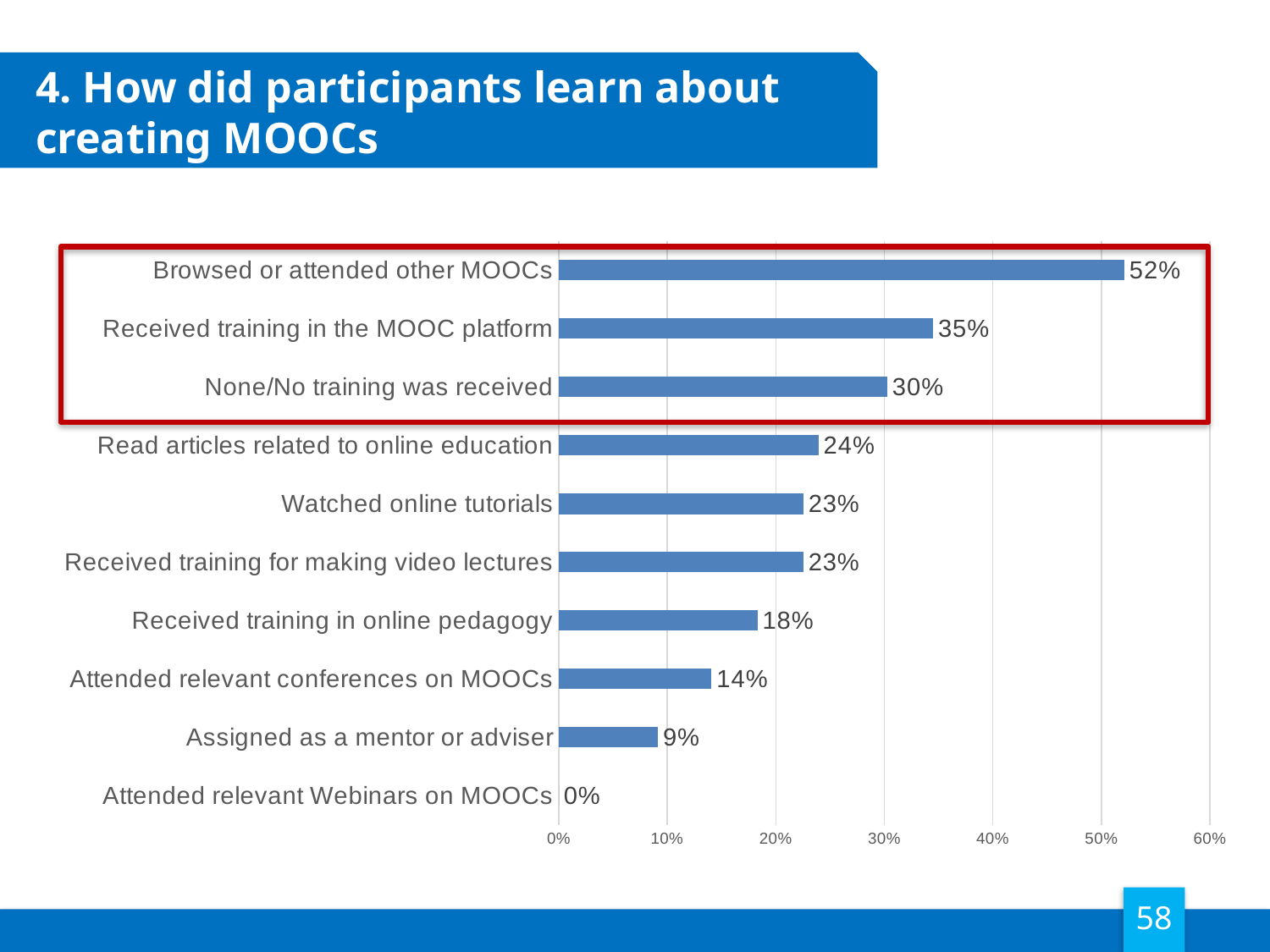
How many categories are enclosed by the red box on the chart? 3 What is the value for 'Received training in the MOOC platform'? 35% Which category has the lowest value? Attended relevant Webinars on MOOCs What is the value for 'Assigned as a mentor or adviser'? 9% Which category has the highest value? Browsed or attended other MOOCs Which is larger: 'None/No training was received' or 'Read articles related to online education'? None/No training was received What kind of chart is shown on the slide? Bar chart What percentage of participants browsed or attended other MOOCs? 52% What percentage of participants received training in online pedagogy? 18% What is the difference between 'Browsed or attended other MOOCs' and 'Received training in the MOOC platform'? 17% Is the value for 'Attended relevant conferences on MOOCs' greater or less than 20%? less How many categories are shown in the chart? 10